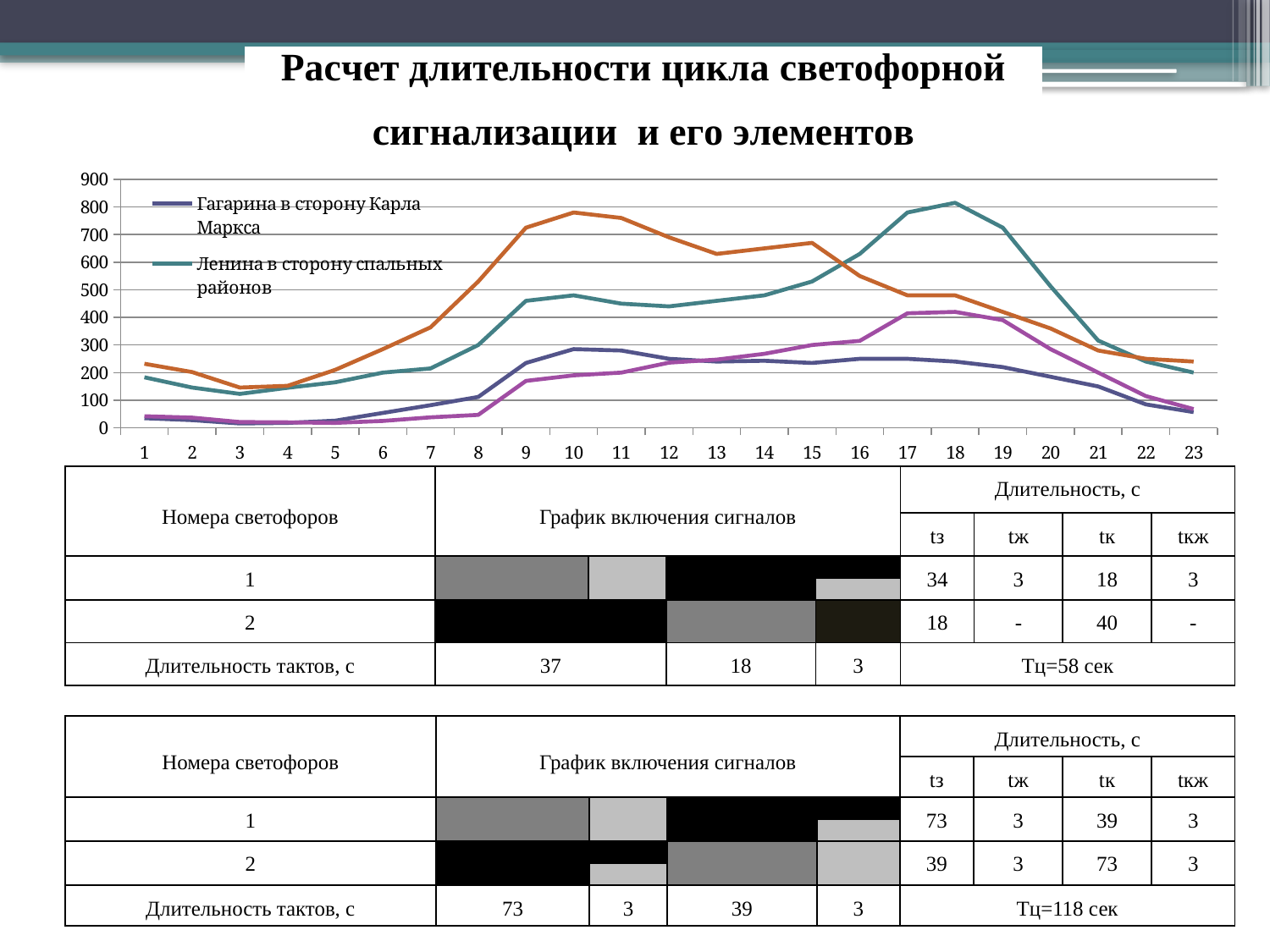
Is the value for "Гагарина в сторону Карла Маркса" at point 1 greater or less than 100? less Is the value for "Ленина в сторону спальных районов" at point 3 greater or less than 200? less Is the value for "Ленина в сторону спальных районов" at point 18 greater or less than 700? greater How many points are labelled along the x axis of the chart? 23 At which x-axis point does "Ленина в сторону спальных районов" reach its highest value? 18 At point 18, which series has the larger value: "Гагарина в сторону Карла Маркса" or "Ленина в сторону спальных районов"? Ленина в сторону спальных районов Does the "Гагарина в сторону Карла Маркса" series rise or fall between points 18 and 23? fall What is the highest value shown on the chart's vertical axis? 900 Does the "Ленина в сторону спальных районов" series rise or fall between points 13 and 18? rise How many series does the chart legend list? 2 What kind of chart is shown on the slide? line chart